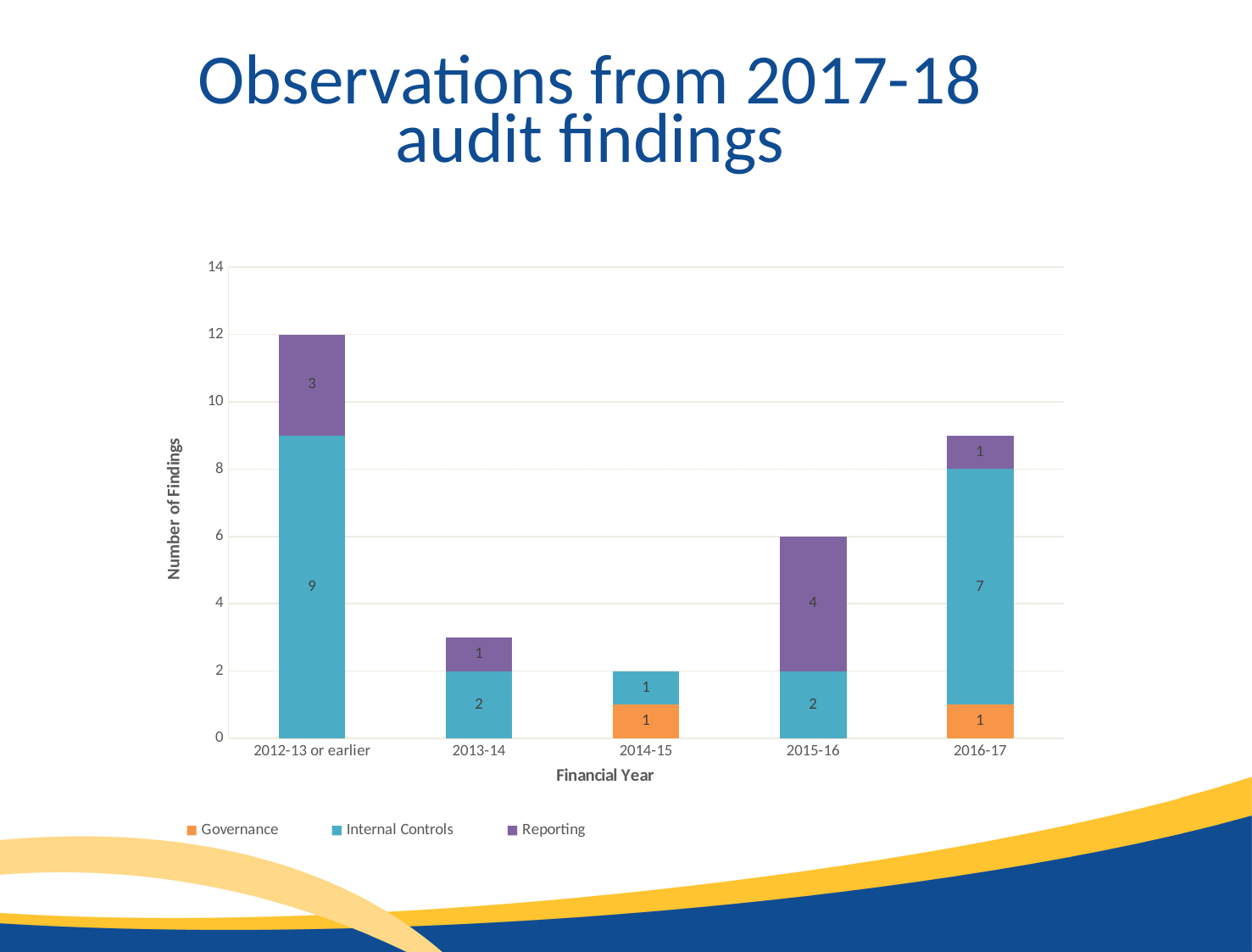
Which financial year has the highest total number of findings? 2012-13 or earlier What is the difference between the Internal Controls values for 2016-17 and 2013-14? 5 What is the Internal Controls value for 2012-13 or earlier? 9 What is the total number of findings for 2016-17? 9 How many series does the legend list? 3 What kind of chart is shown on the slide? Stacked bar chart What is the Governance value for 2014-15? 1 What is the total number of findings for 2012-13 or earlier? 12 Which is larger, the Reporting value for 2015-16 or the Reporting value for 2012-13 or earlier? 2015-16 How many financial year categories are shown on the x axis? 5 Which financial year has the lowest total number of findings? 2014-15 What is the Reporting value for 2015-16? 4